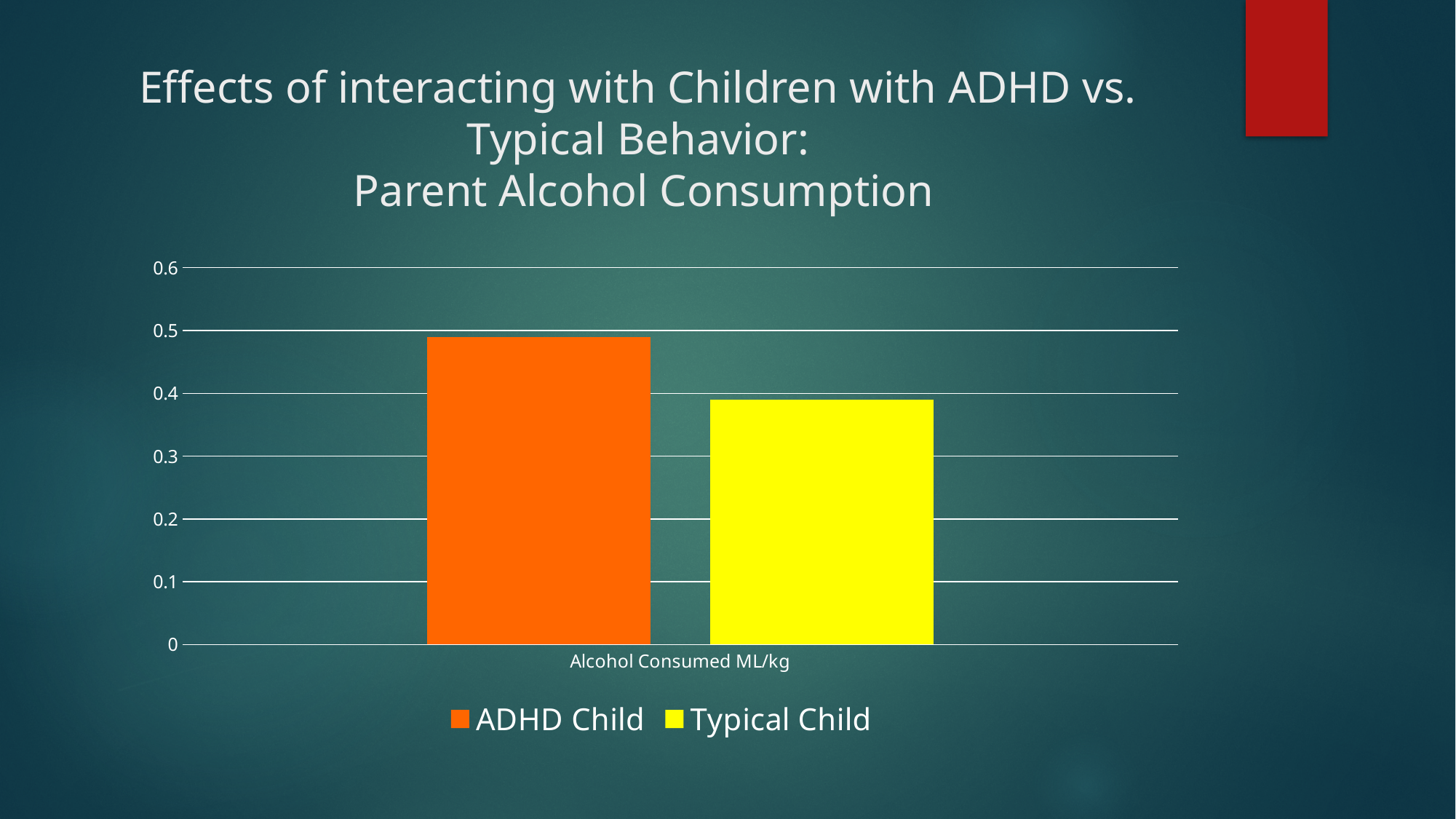
Which series has the lowest value for Alcohol Consumed ML/kg? Typical Child Is the value for Typical Child greater or less than 0.5? less Is the value for ADHD Child greater or less than 0.4? greater What kind of chart is shown on the slide? bar chart Is the value for ADHD Child greater or less than 0.6? less What is the label on the x axis of the chart? Alcohol Consumed ML/kg Which series has the taller bar, ADHD Child or Typical Child? ADHD Child How many series does the legend list? 2 How many categories are shown on the x axis? 1 What colour is the bar for Typical Child? yellow Which series has the highest value for Alcohol Consumed ML/kg? ADHD Child